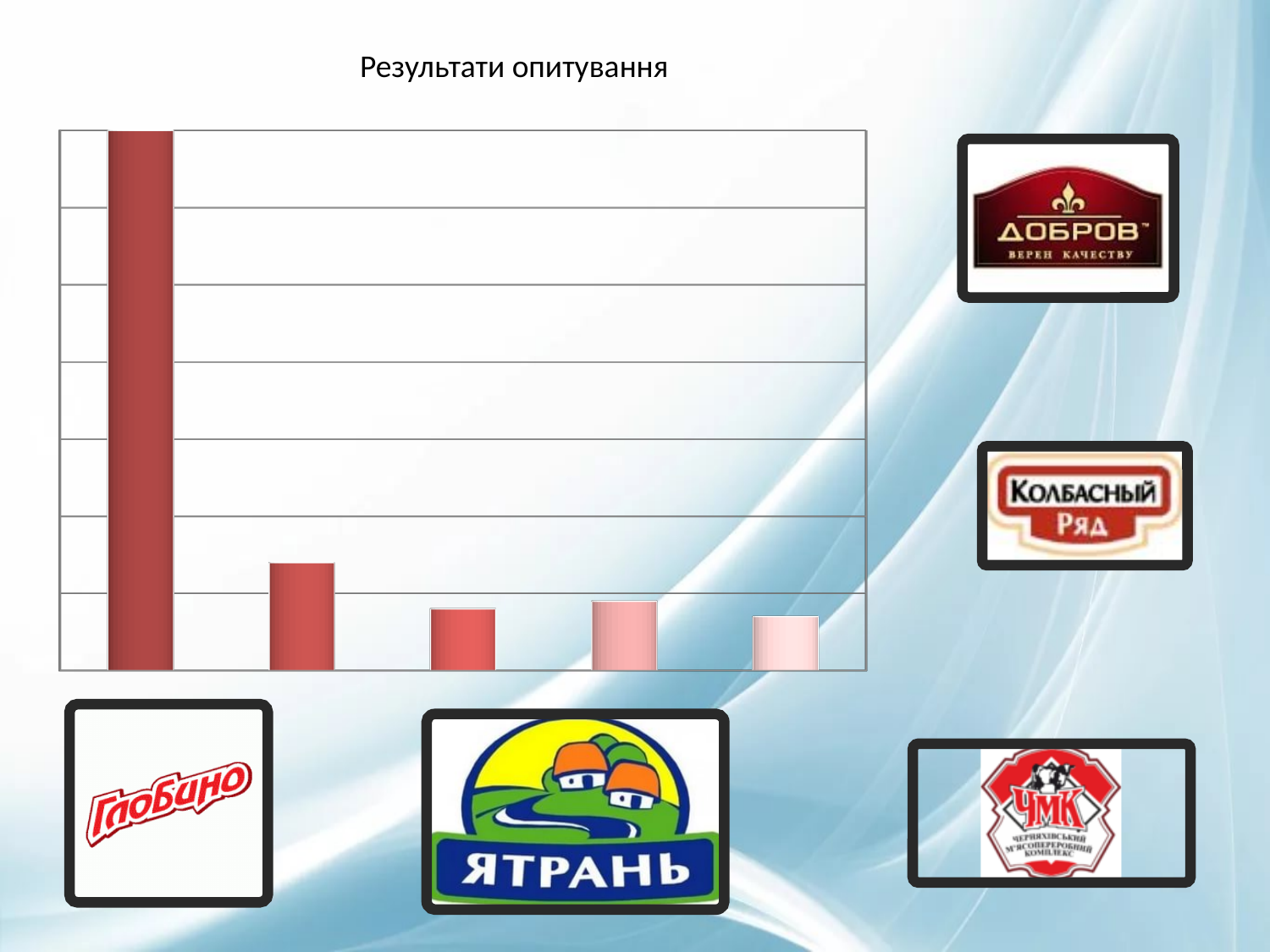
Which bar in the chart is the highest? the leftmost (first) bar How many bars are plotted in the chart? 5 Which is taller, the first bar from the left or the fifth bar from the left? the first bar Which is taller, the second bar from the left or the third bar from the left? the second bar Which is taller, the first bar from the left or the second bar from the left? the first bar What is the title shown above the chart? Результати опитування What colour are the bars in the chart? red (shades of red/pink) What kind of chart is shown on the slide? bar chart